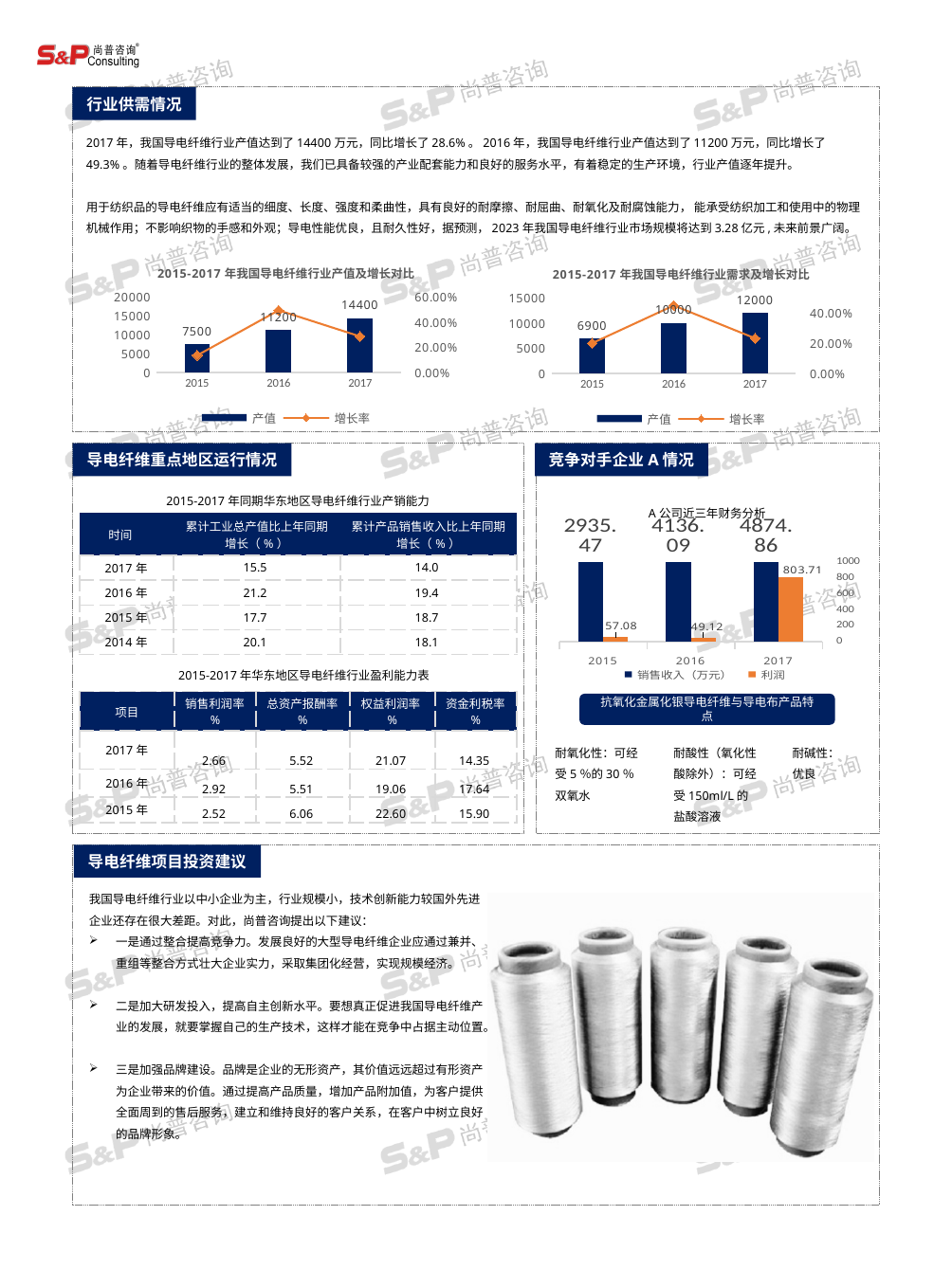
In the chart titled 2015-2017年我国导电纤维行业产值及增长对比, does the 产值 rise or fall from 2015 to 2017? rise In the chart titled 2015-2017年我国导电纤维行业需求及增长对比, is the 增长率 for 2017 greater or less than 40.00%? less In the chart titled 2015-2017年我国导电纤维行业产值及增长对比, what is the 产值 value for 2017? 14400 In the chart titled A公司近三年财务分析, what is the 销售收入 for 2016? 4136.09 In the chart titled 2015-2017年我国导电纤维行业需求及增长对比, how many series does the legend list? 2 In the chart titled A公司近三年财务分析, what is the 利润 for 2017? 803.71 What kind of chart is the chart titled A公司近三年财务分析? bar chart In the chart titled 2015-2017年我国导电纤维行业需求及增长对比, what is the difference between the 2017 and 2015 bar values? 5100 In the chart titled A公司近三年财务分析, which year has the lowest 利润? 2016 In the chart titled 2015-2017年我国导电纤维行业产值及增长对比, which year has the lowest 产值? 2015 In the chart titled 2015-2017年我国导电纤维行业产值及增长对比, what is the difference between the 产值 for 2017 and 2016? 3200 In the chart titled 2015-2017年我国导电纤维行业需求及增长对比, what is the 产值 value for 2016? 10000